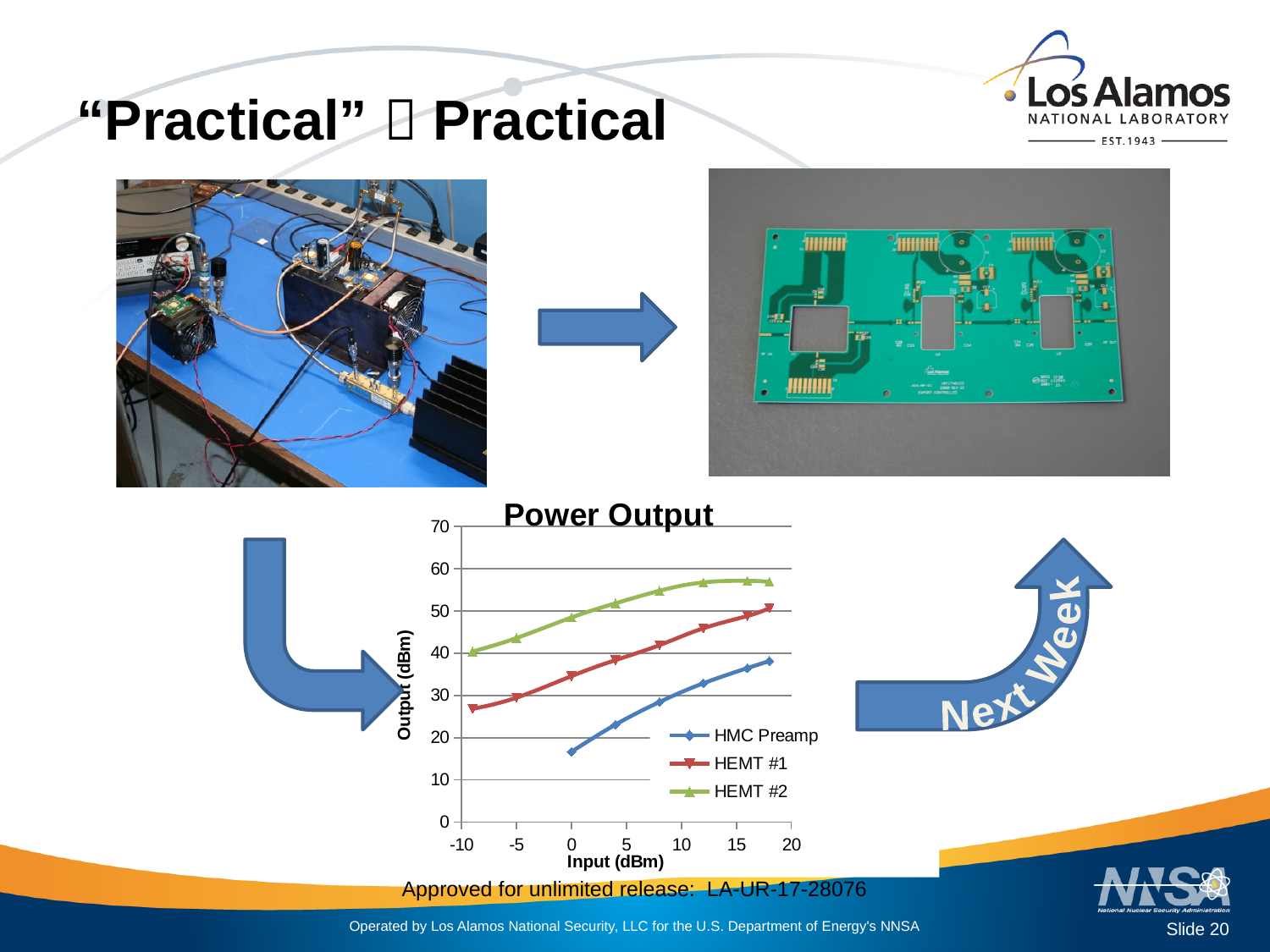
In the Power Output chart, is the highest output reached by HEMT #2 greater or less than 60? less What is the title of the chart on the slide? Power Output What is the label of the y axis on the Power Output chart? Output (dBm) In the Power Output chart, which series has the lowest output values across the input range? HMC Preamp What kind of chart is the Power Output chart? line chart In the Power Output chart, does the output of HEMT #1 rise or fall as the input increases? rise In the Power Output chart, at an input of 10 dBm, which series has the larger output: HEMT #2 or HMC Preamp? HEMT #2 In the Power Output chart, is the output of HEMT #2 at an input of 0 dBm greater or less than 40? greater In the Power Output chart, is the output of HMC Preamp at an input of 0 dBm greater or less than 20? less How many series does the legend of the Power Output chart list? 3 In the Power Output chart, which series has the highest output values across the input range? HEMT #2 In the Power Output chart, at an input of -5 dBm, which series has the larger output: HEMT #1 or HEMT #2? HEMT #2